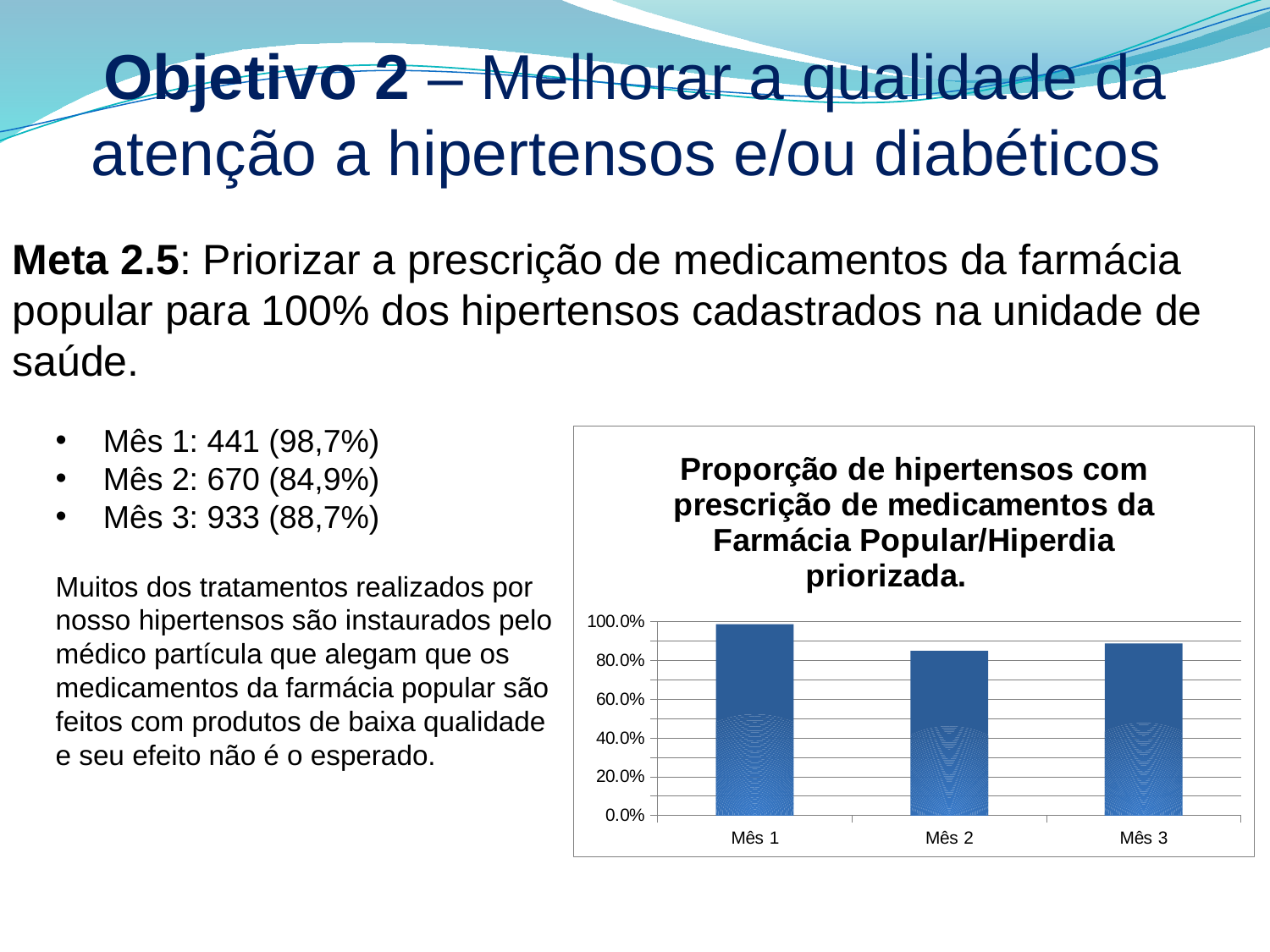
What is the title of the chart? Proporção de hipertensos com prescrição de medicamentos da Farmácia Popular/Hiperdia priorizada. Which has a larger value in the chart, Mês 1 or Mês 2? Mês 1 Is the value for Mês 1 greater or less than 80.0%? greater Does the value rise or fall from Mês 2 to Mês 3? rise Is the value for Mês 3 greater or less than 60.0%? greater How many categories (months) are shown on the x axis of the chart? 3 Is the value for Mês 2 greater or less than 100.0%? less Which month has the highest bar in the chart? Mês 1 Which has a larger value in the chart, Mês 3 or Mês 2? Mês 3 Which month has the lowest bar in the chart? Mês 2 Does the value rise or fall from Mês 1 to Mês 2? fall What kind of chart is shown on the slide? bar chart